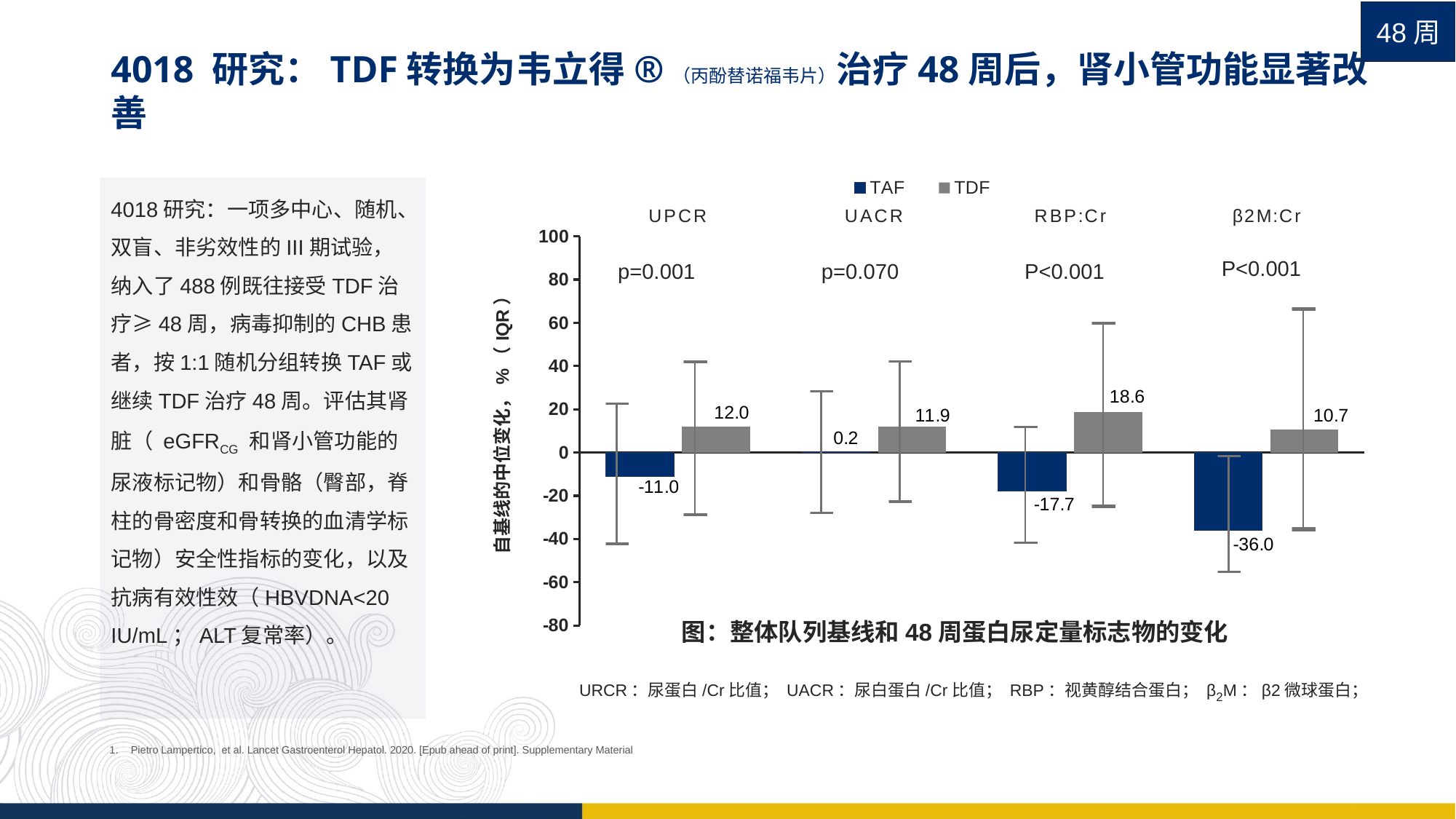
Which is larger, the TDF value for UPCR or the TDF value for β2M:Cr? TDF value for UPCR What kind of chart is shown? bar chart Which category has the lowest TAF value? β2M:Cr How many series does the legend list? 2 Which category has the highest TDF value? RBP:Cr What is the TDF value for UACR? 11.9 What p-value is shown above the UACR category? p=0.070 What is the TAF value for UPCR? -11.0 What is the TAF value for β2M:Cr? -36.0 How many categories are shown on the x axis? 4 What is the difference between the TDF and TAF values for UPCR? 23.0 What is the TDF value for RBP:Cr? 18.6